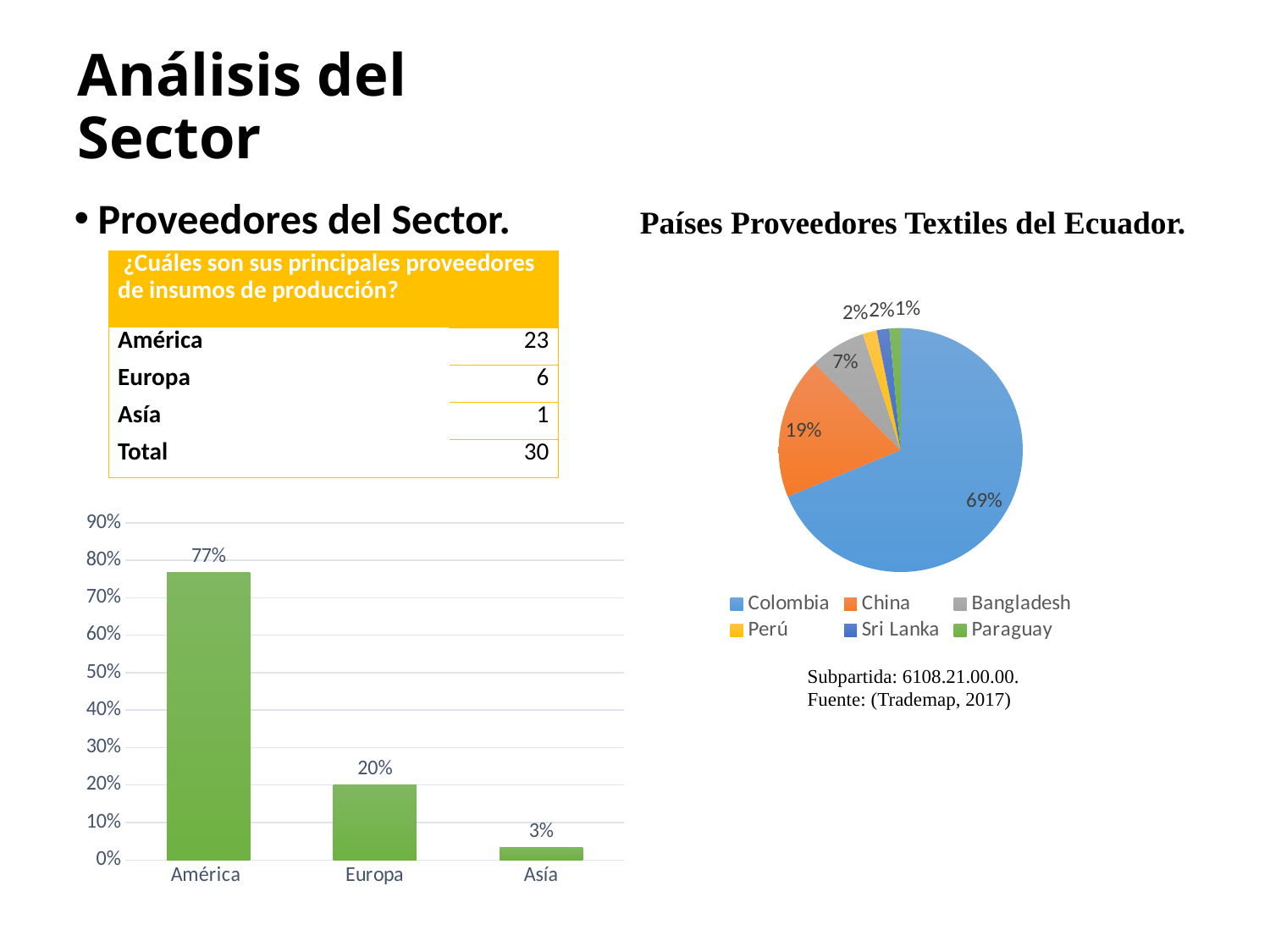
In the pie chart 'Países Proveedores Textiles del Ecuador', what share does China have? 19% In the pie chart 'Países Proveedores Textiles del Ecuador', which country has the largest share? Colombia What kind of chart is the chart on the left of the slide? Bar chart In the pie chart 'Países Proveedores Textiles del Ecuador', what colour is the Colombia slice? Blue In the pie chart 'Países Proveedores Textiles del Ecuador', what share does Colombia have? 69% How many entries does the legend of the pie chart 'Países Proveedores Textiles del Ecuador' list? 6 In the bar chart on the left, how many categories are shown? 3 In the bar chart on the left, which category has the lowest value? Asía In the bar chart on the left, what is the difference between the values for América and Europa? 57% In the bar chart on the left, what is the value for Europa? 20% In the bar chart on the left, what is the value for América? 77% In the pie chart 'Países Proveedores Textiles del Ecuador', which is larger, the share for China or the share for Bangladesh? China